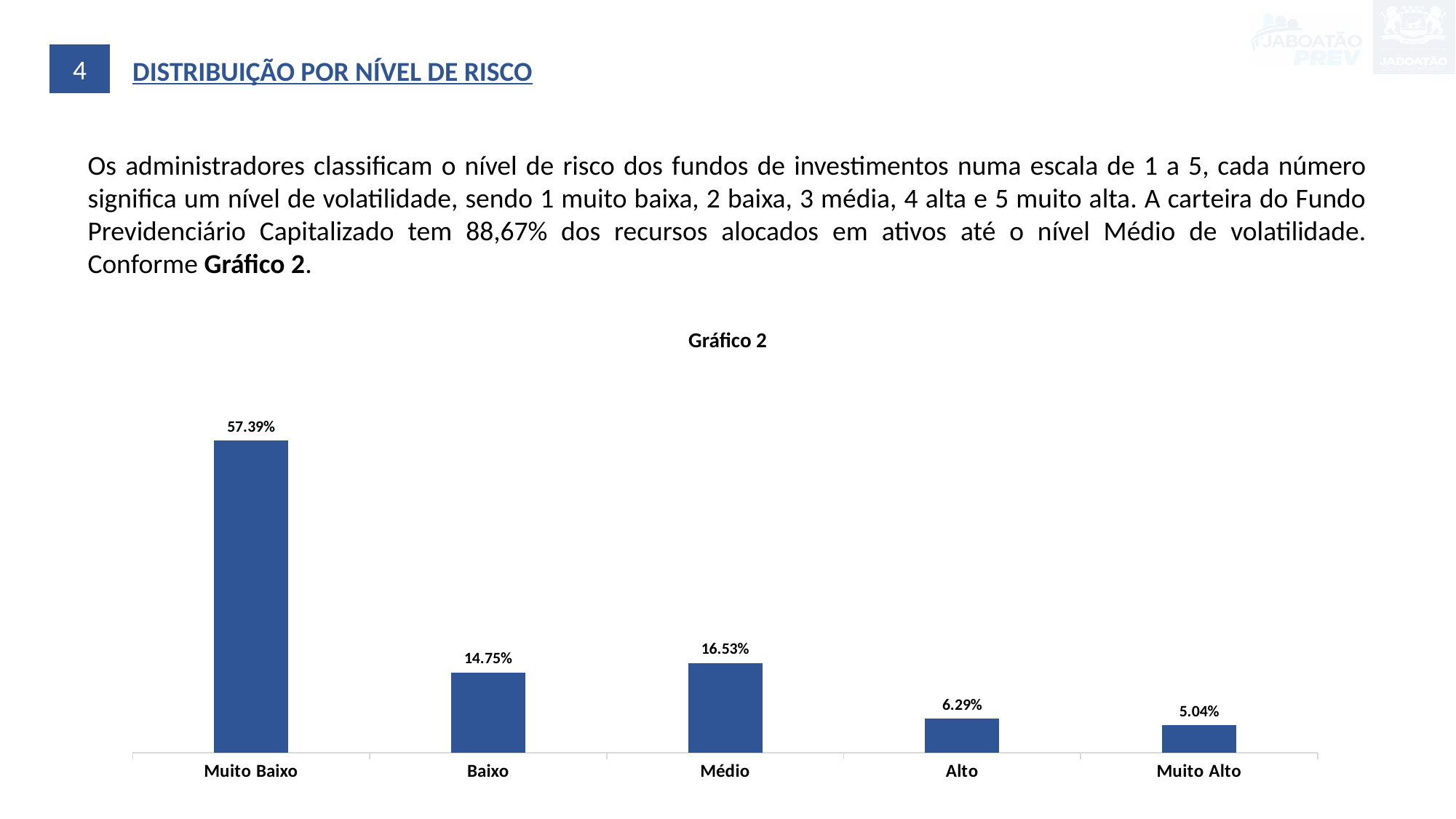
What is the difference between the values for Médio and Baixo? 1.78% Which category has the highest value? Muito Baixo What is the value for Médio? 16.53% What is the value for Muito Alto? 5.04% How many categories are shown on the x axis? 5 What is the difference between the values for Alto and Muito Alto? 1.25% Which is larger, the value for Baixo or the value for Médio? Médio What is the title of the chart? Gráfico 2 Which category has the lowest value? Muito Alto What kind of chart is shown? Bar chart What is the value for Muito Baixo? 57.39% What is the combined value of Muito Baixo, Baixo and Médio? 88.67%